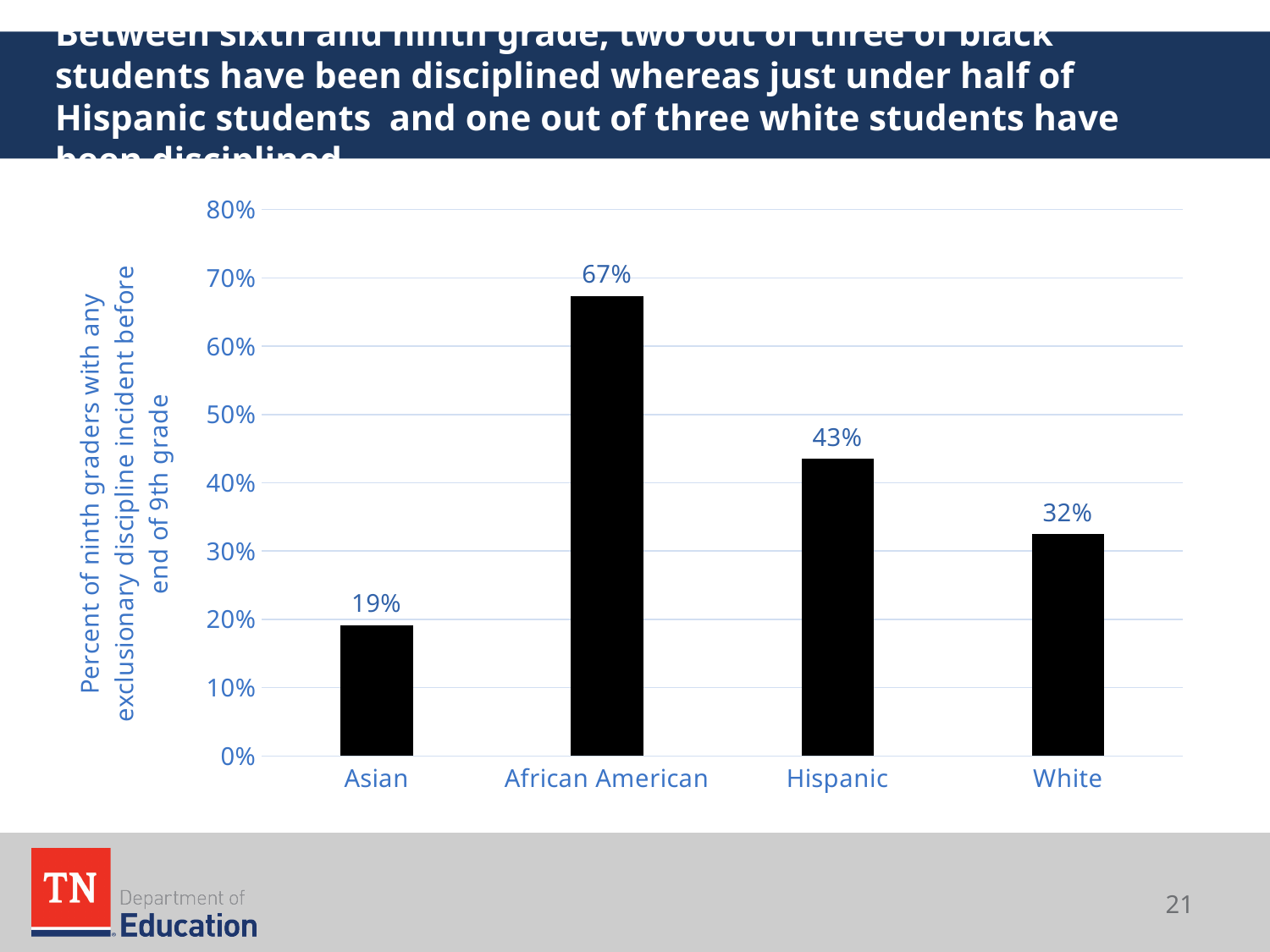
Which is larger, the value for Hispanic students or the value for White students? Hispanic How many categories are shown on the x axis? 4 Which category has the lowest value? Asian What is the value for White students? 32% What is the value for African American students? 67% Which category has the highest value? African American What is the difference between the values for Hispanic and Asian students? 24% What is the value for Hispanic students? 43% Is the value for African American students greater or less than 60%? greater What is the value for Asian students? 19% What kind of chart is shown on the slide? bar chart What is the difference between the values for African American and White students? 35%